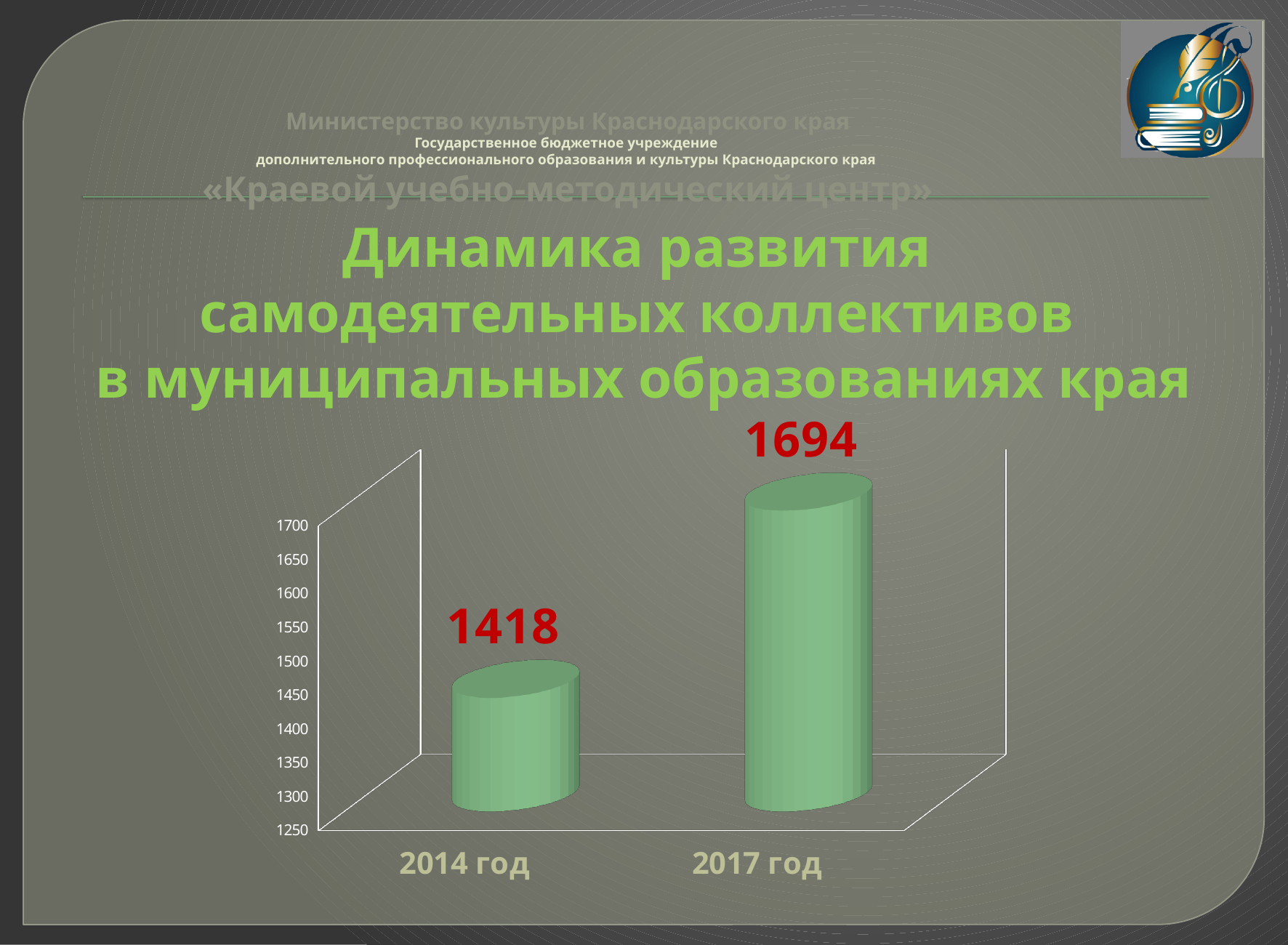
What kind of chart is shown on the slide? bar chart Do the values rise or fall from 2014 год to 2017 год? rise What is the value for 2014 год? 1418 What is the difference between the values for 2017 год and 2014 год? 276 Which year has the higher value? 2017 год Is the value for 2014 год larger or smaller than the value for 2017 год? smaller How many categories are shown on the x axis? 2 Which year has the lower value? 2014 год Is the value for 2017 год greater or less than 1600? greater Is the value for 2014 год greater or less than 1500? less What is the lowest value shown on the vertical axis? 1250 What is the value for 2017 год? 1694